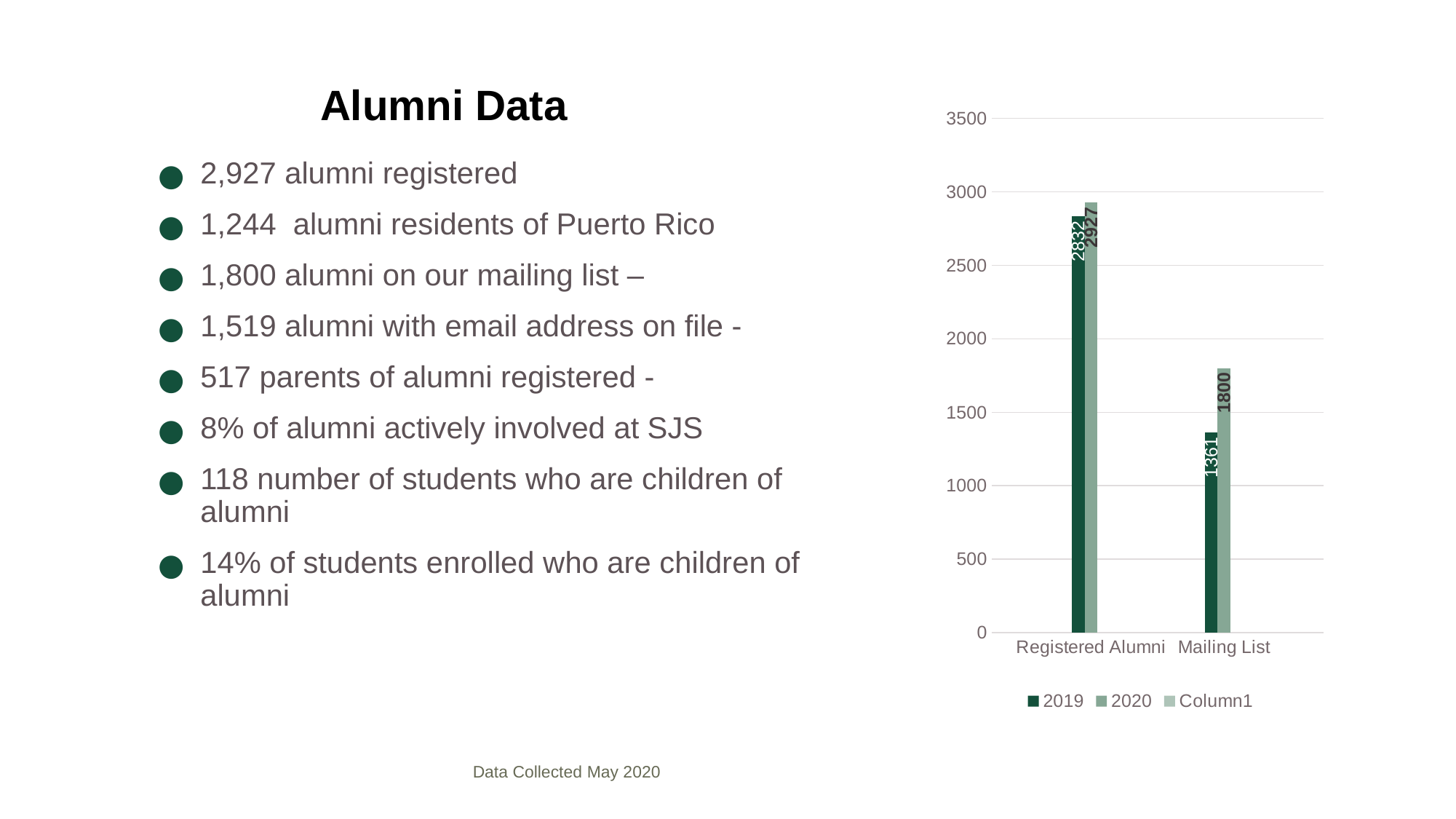
What is the 2020 value for Mailing List? 1800 What is the 2019 value for Mailing List? 1361 Which is larger for Mailing List, the 2019 value or the 2020 value? 2020 What kind of chart is shown on the slide? bar chart What is the difference between the 2020 and 2019 values for Mailing List? 439 What is the difference between the 2020 and 2019 values for Registered Alumni? 95 What is the 2019 value for Registered Alumni? 2832 How many series does the legend list? 3 Which category has the lowest 2019 value? Mailing List How many categories are shown on the x axis? 2 What is the 2020 value for Registered Alumni? 2927 Which category has the highest 2020 value? Registered Alumni